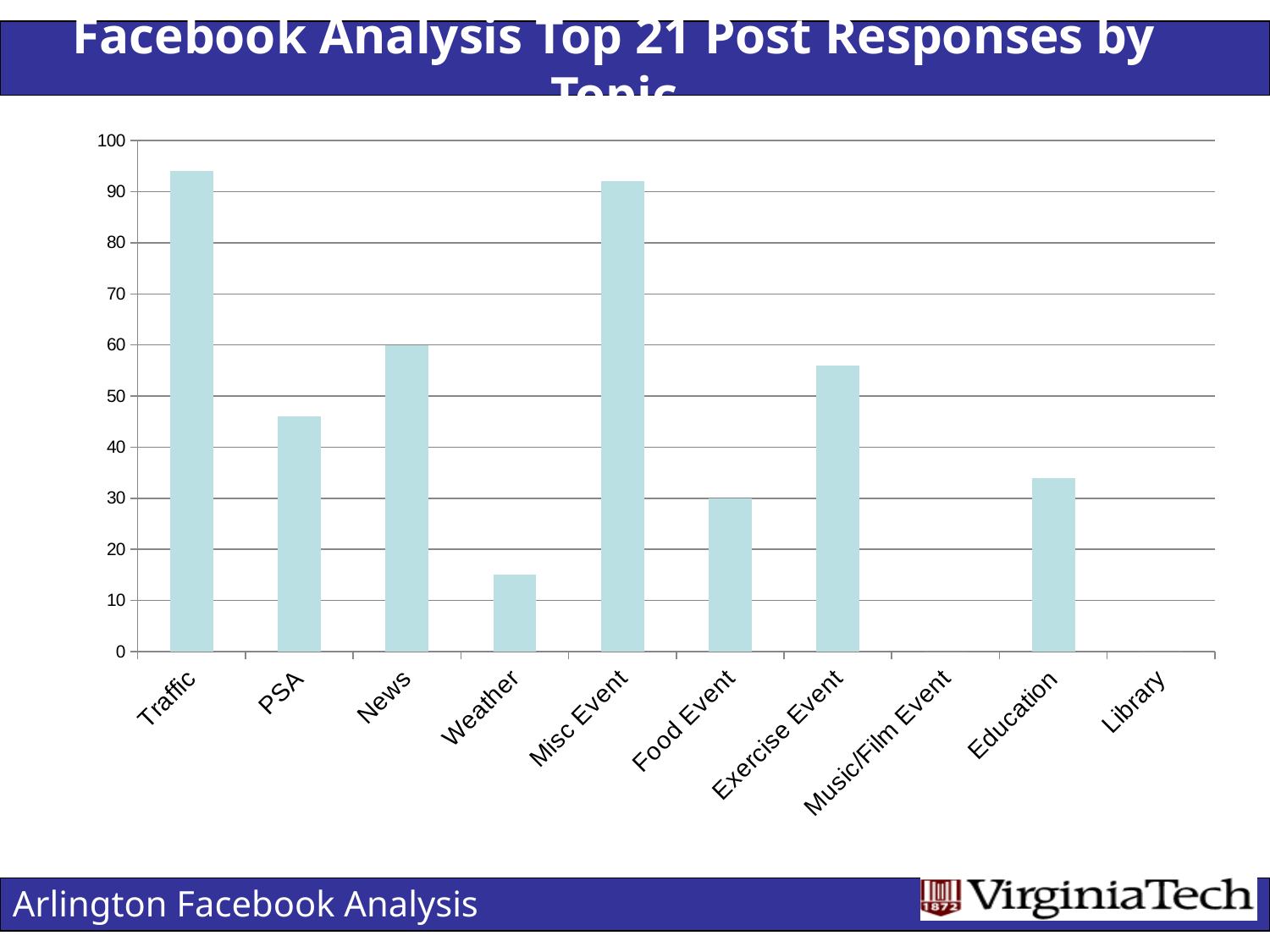
Is the value for PSA greater or less than 50? less Which is larger, the value for News or the value for PSA? News Is the value for Education greater or less than 40? less Is the value for Weather greater or less than 20? less What is the value for Food Event? 30 What kind of chart is shown on the slide? bar chart What colour are the bars in the chart? light blue Which is larger, the value for Exercise Event or the value for Education? Exercise Event How many topic categories are shown on the x axis of the chart? 10 What is the value for News? 60